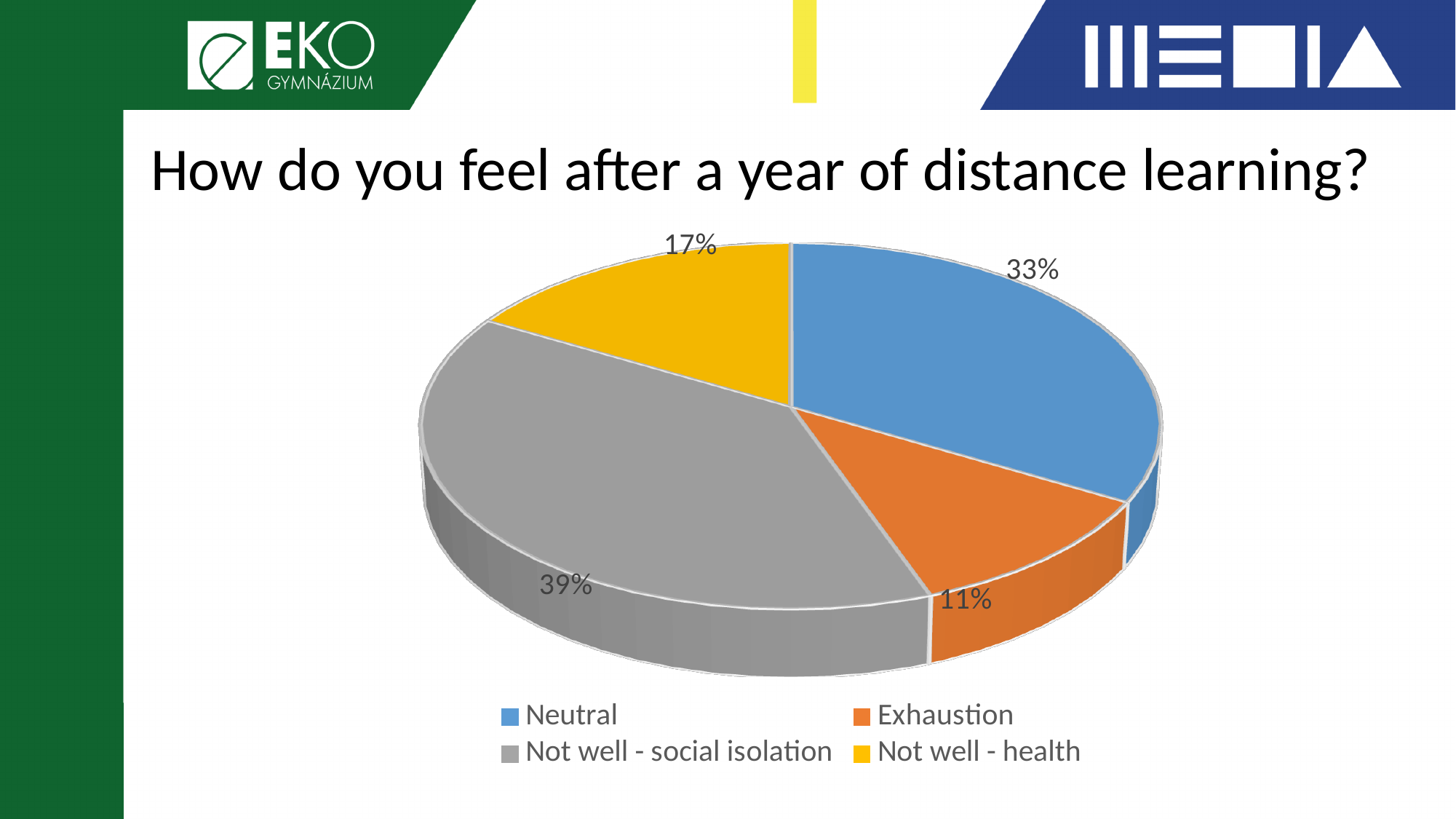
What kind of chart is shown on the slide? Pie chart Which category has the smallest slice of the pie? Exhaustion What share of the pie does 'Not well - social isolation' represent? 39% Which category has the largest slice of the pie? Not well - social isolation Which is larger, the share for 'Not well - health' or the share for 'Exhaustion'? Not well - health Which colour represents 'Exhaustion' in the pie chart? Orange What share of the pie does 'Exhaustion' represent? 11% What share of the pie does 'Not well - health' represent? 17% How many categories are shown in the pie chart? 4 What is the difference in percentage points between 'Not well - social isolation' and 'Neutral'? 6 What share of the pie does 'Neutral' represent? 33% What is the title of the chart? How do you feel after a year of distance learning?